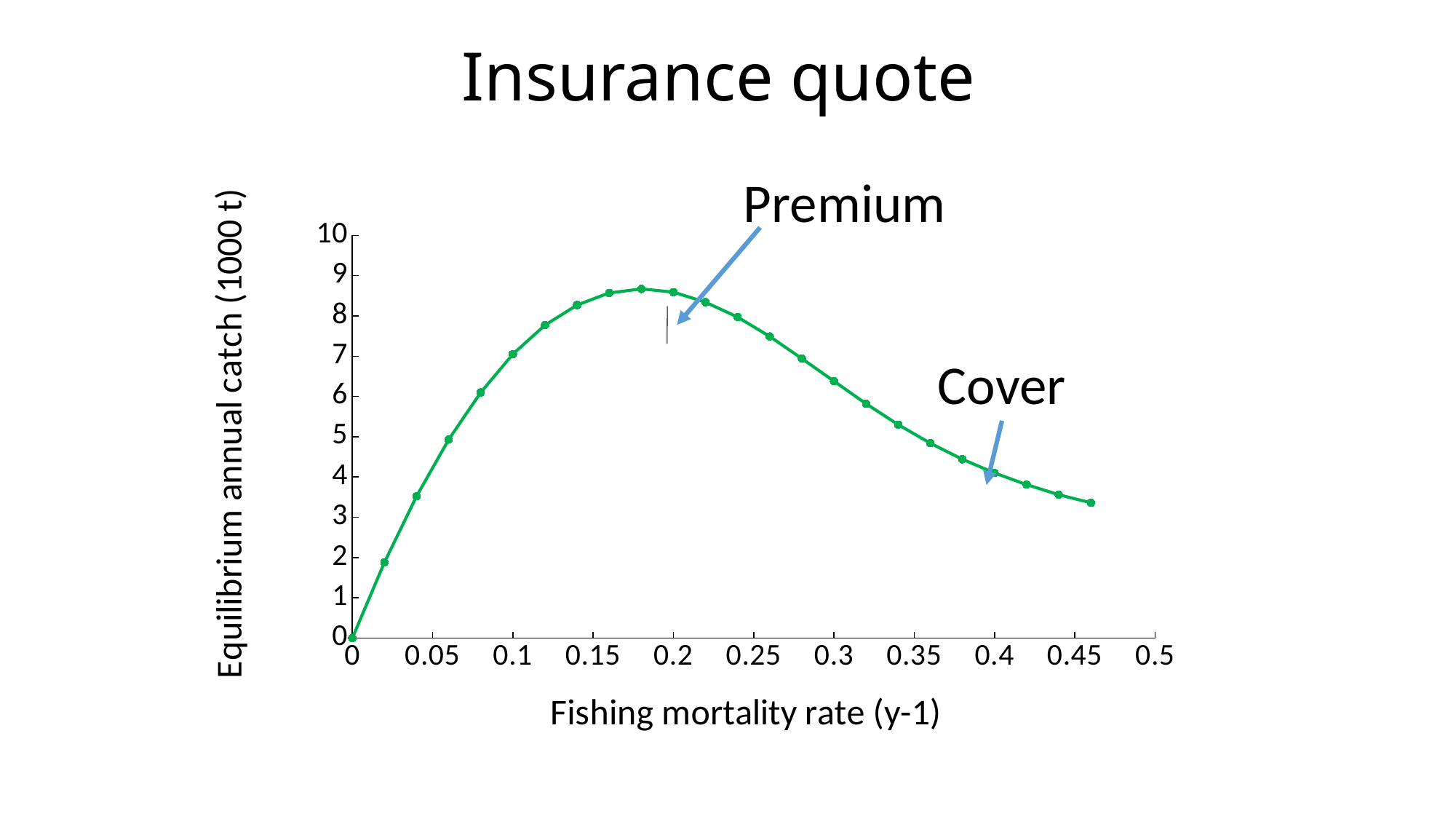
How does the equilibrium annual catch change as the fishing mortality rate increases from 0 to 0.46? rises then falls Is the equilibrium annual catch at a fishing mortality rate of 0.46 greater or less than 4? less Is the equilibrium annual catch at a fishing mortality rate of 0.1 greater or less than 6? greater What is the title of the slide? Insurance quote What is the label of the x axis? Fishing mortality rate (y-1) What is the equilibrium annual catch at a fishing mortality rate of 0? 0 Which has the higher equilibrium annual catch: a fishing mortality rate of 0.1 or 0.3? 0.1 Which has the higher equilibrium annual catch: a fishing mortality rate of 0.2 or 0.46? 0.2 What kind of chart is shown on the slide? line chart Is the equilibrium annual catch at a fishing mortality rate of 0.2 greater or less than 8? greater At which fishing mortality rate is the equilibrium annual catch lowest? 0